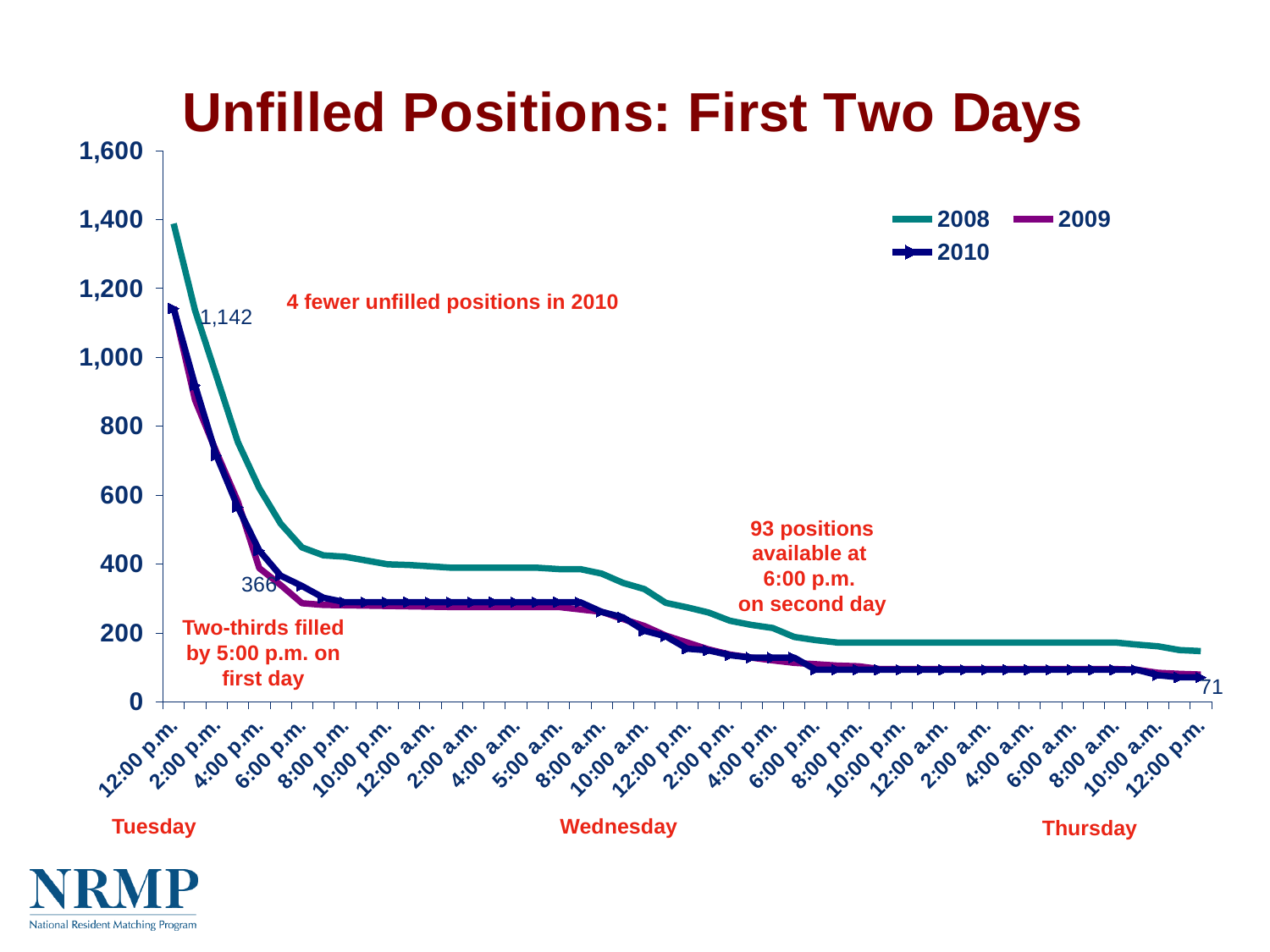
What is the labelled value for 2010 at 12:00 p.m. on Tuesday? 1,142 What is the labelled value for 2010 at 12:00 p.m. on Thursday, the last point on the chart? 71 Which series has the highest value at 12:00 p.m. on Tuesday? 2008 Do the values for each series rise or fall from left to right along the x axis? fall What kind of chart is shown on the slide? line chart Which years are listed in the chart legend? 2008, 2009, 2010 What is the difference between the 2010 value at 12:00 p.m. Tuesday (1,142) and the 2010 value at 12:00 p.m. Thursday (71)? 1,071 What is the title of the chart? Unfilled Positions: First Two Days At 8:00 p.m. on Tuesday, which series has the larger value, 2008 or 2010? 2008 Is the 2008 value at 12:00 p.m. on Thursday greater or less than 200? less What value is labelled on the 2010 line between 4:00 p.m. and 6:00 p.m. on Tuesday? 366 How many series does the legend list? 3